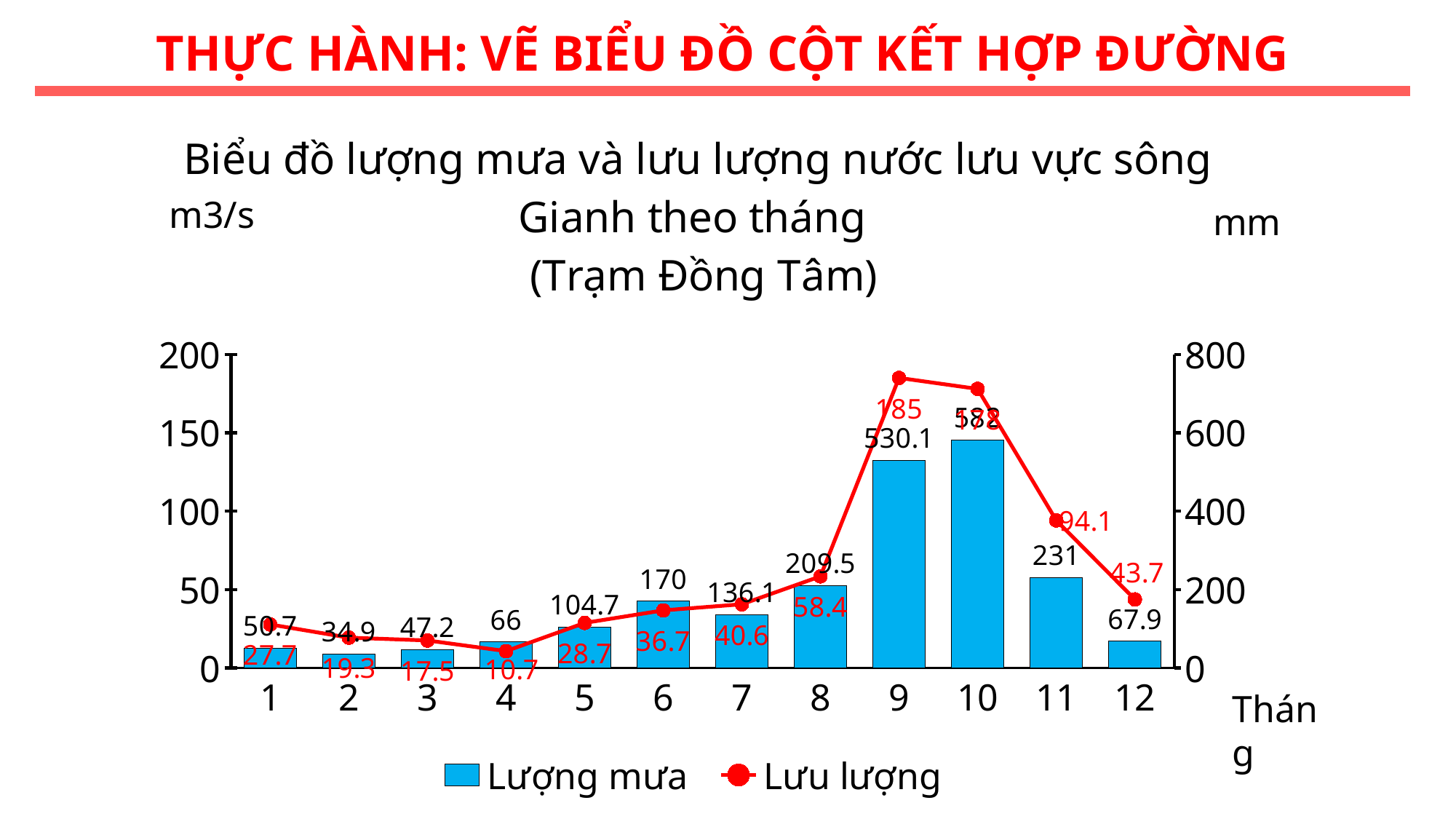
How many months are shown on the x axis? 12 What unit is shown on the right-hand axis? mm Which month has the lowest water flow (Lưu lượng)? 4 What is the water flow (Lưu lượng) value for month 4? 10.7 Which month has higher rainfall (Lượng mưa), month 5 or month 12? 5 Which month has the highest water flow (Lưu lượng)? 9 What is the rainfall (Lượng mưa) value for month 8? 209.5 What is the rainfall (Lượng mưa) value for month 9? 530.1 Which month has the lowest rainfall (Lượng mưa)? 2 What is the water flow (Lưu lượng) value for month 11? 94.1 What is the difference in rainfall (Lượng mưa) between month 6 and month 7? 33.9 How many series does the legend list? 2